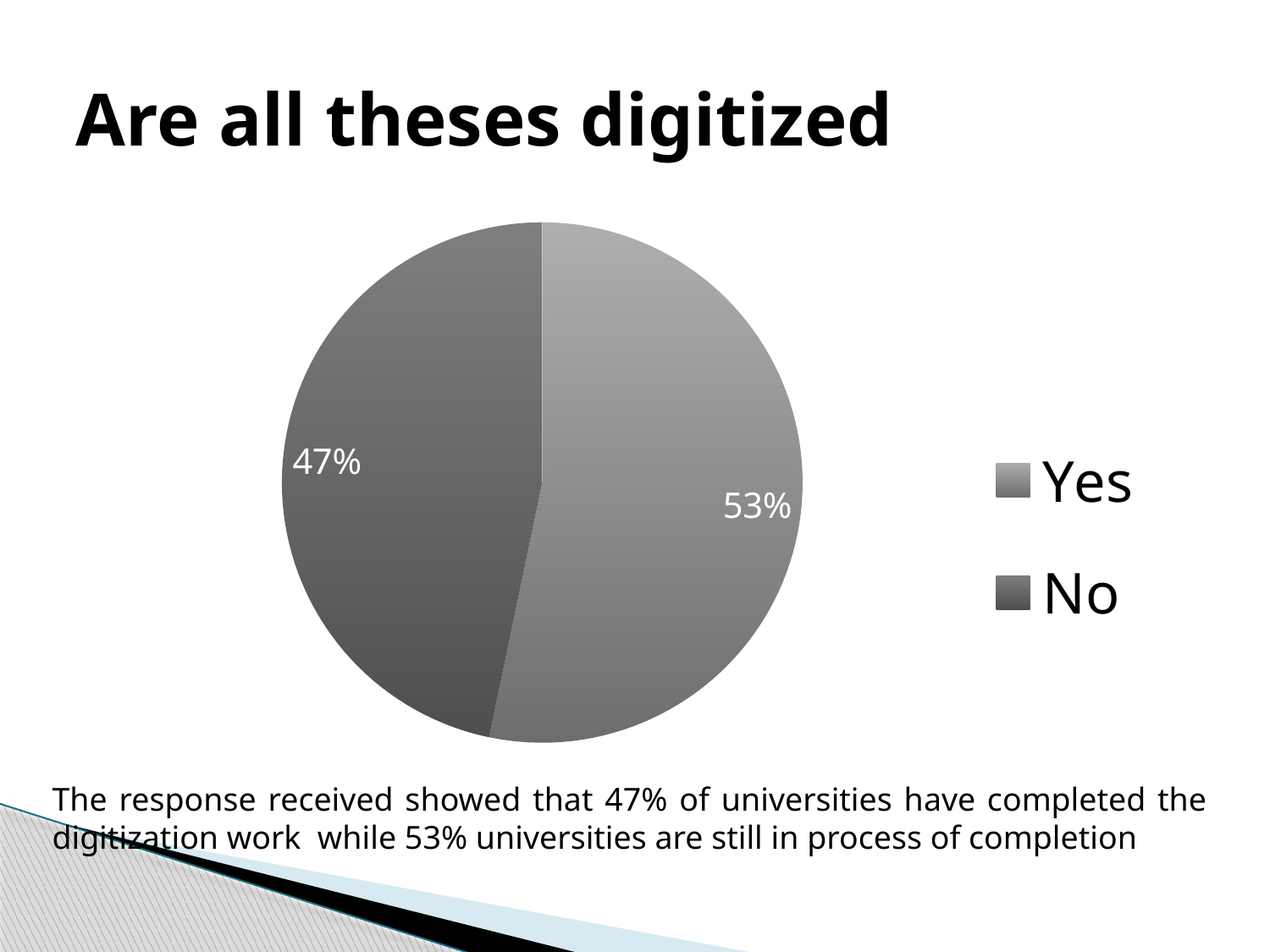
How many entries does the legend list? 2 Which legend entry is shown with the darker shade? No Which slice is the smallest in the pie chart? No Which slice is the largest in the pie chart? Yes Which is larger, the Yes slice or the No slice? Yes What is the difference in percentage points between the Yes and No slices? 6 What share of the pie does the No slice represent? 47% What is the title of the chart on the slide? Are all theses digitized What percentage is shown for the Yes slice? 53% What percentage is shown for the No slice? 47% How many slices does the pie chart have? 2 What kind of chart is shown on the slide? pie chart